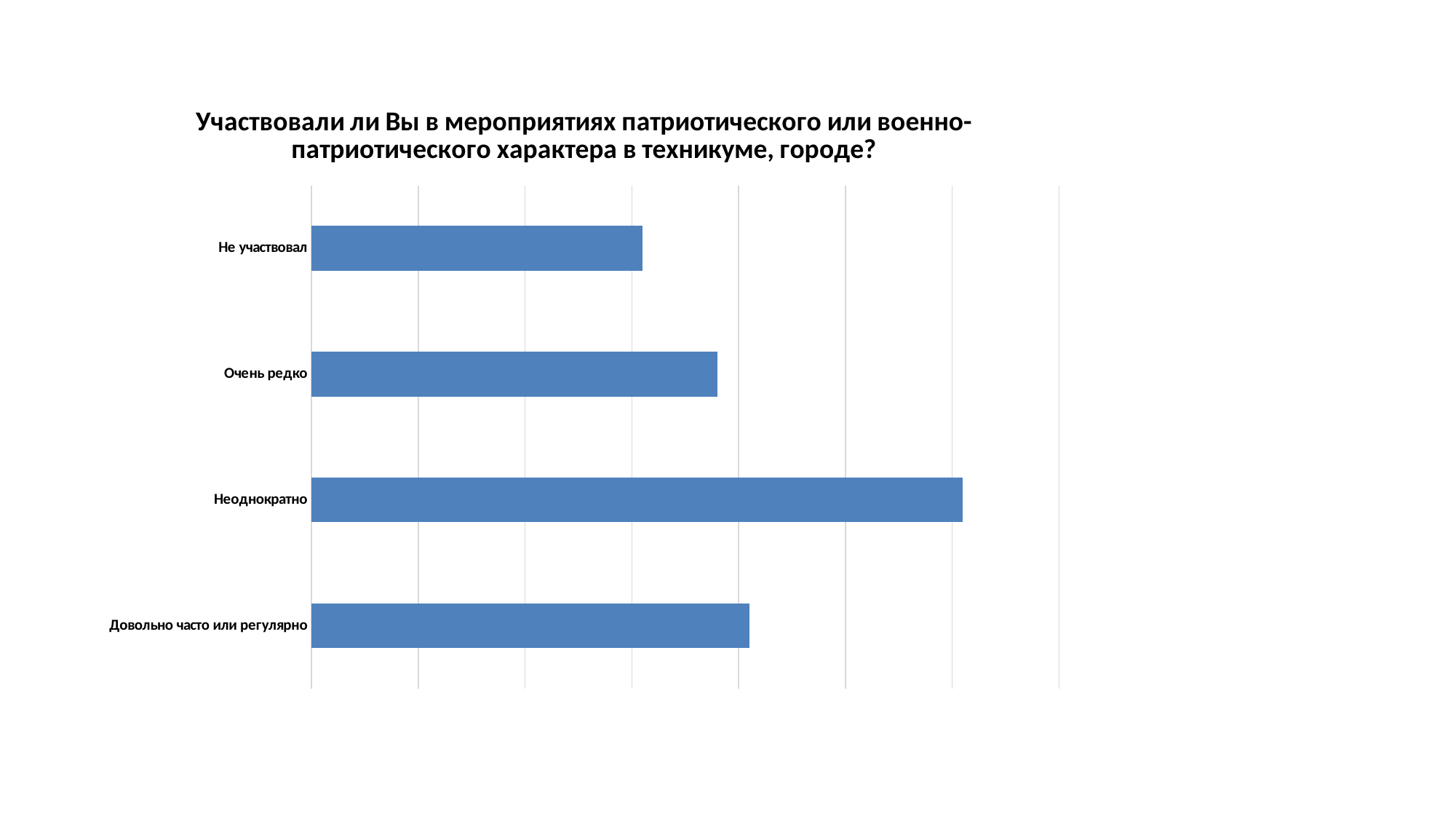
Which is larger, the value for "Не участвовал" or the value for "Очень редко"? Очень редко Which category has the lowest value in the chart? Не участвовал Which is larger, the value for "Не участвовал" or the value for "Довольно часто или регулярно"? Довольно часто или регулярно What kind of chart is shown on the slide? bar chart Which is larger, the value for "Не участвовал" or the value for "Неоднократно"? Неоднократно Which category has the highest value in the chart? Неоднократно Which category label appears at the bottom of the chart? Довольно часто или регулярно What is the title of the chart? Участвовали ли Вы в мероприятиях патриотического или военно-патриотического характера в техникуме, городе? How many categories are plotted in the chart? 4